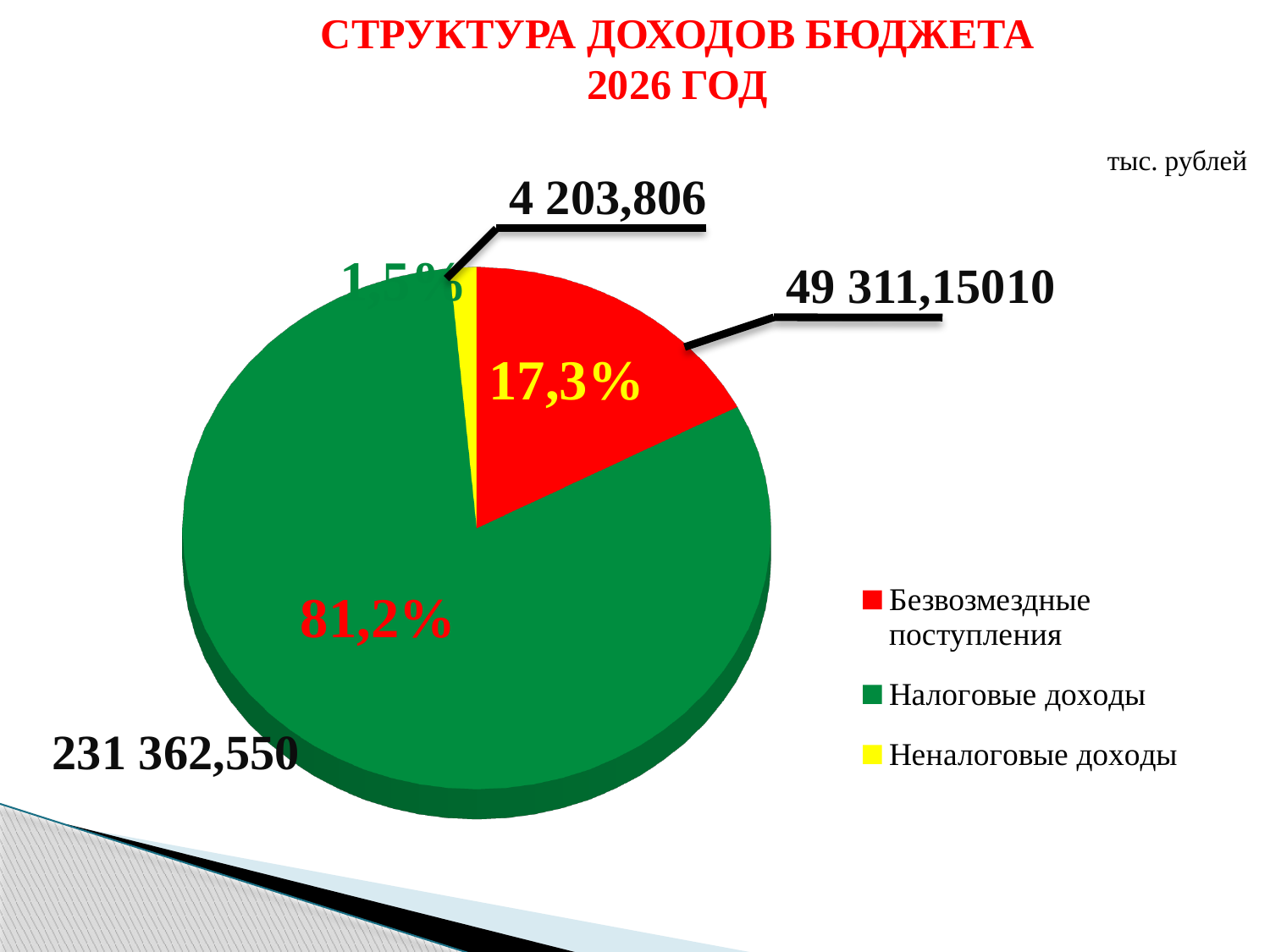
What is the difference in percentage points between the shares of Налоговые доходы and Безвозмездные поступления? 63,9% Which is larger, Безвозмездные поступления or Неналоговые доходы? Безвозмездные поступления What is the value shown for Неналоговые доходы? 4 203,806 Which category has the smallest slice of the pie? Неналоговые доходы Which category has the largest slice of the pie? Налоговые доходы What is the value shown for Налоговые доходы? 231 362,550 What kind of chart is shown on the slide? pie chart What is the value shown for Безвозмездные поступления? 49 311,15010 What share of the pie does Налоговые доходы take? 81,2% What share of the pie does Безвозмездные поступления take? 17,3% How many slices does the pie chart have? 3 How many entries does the legend list? 3